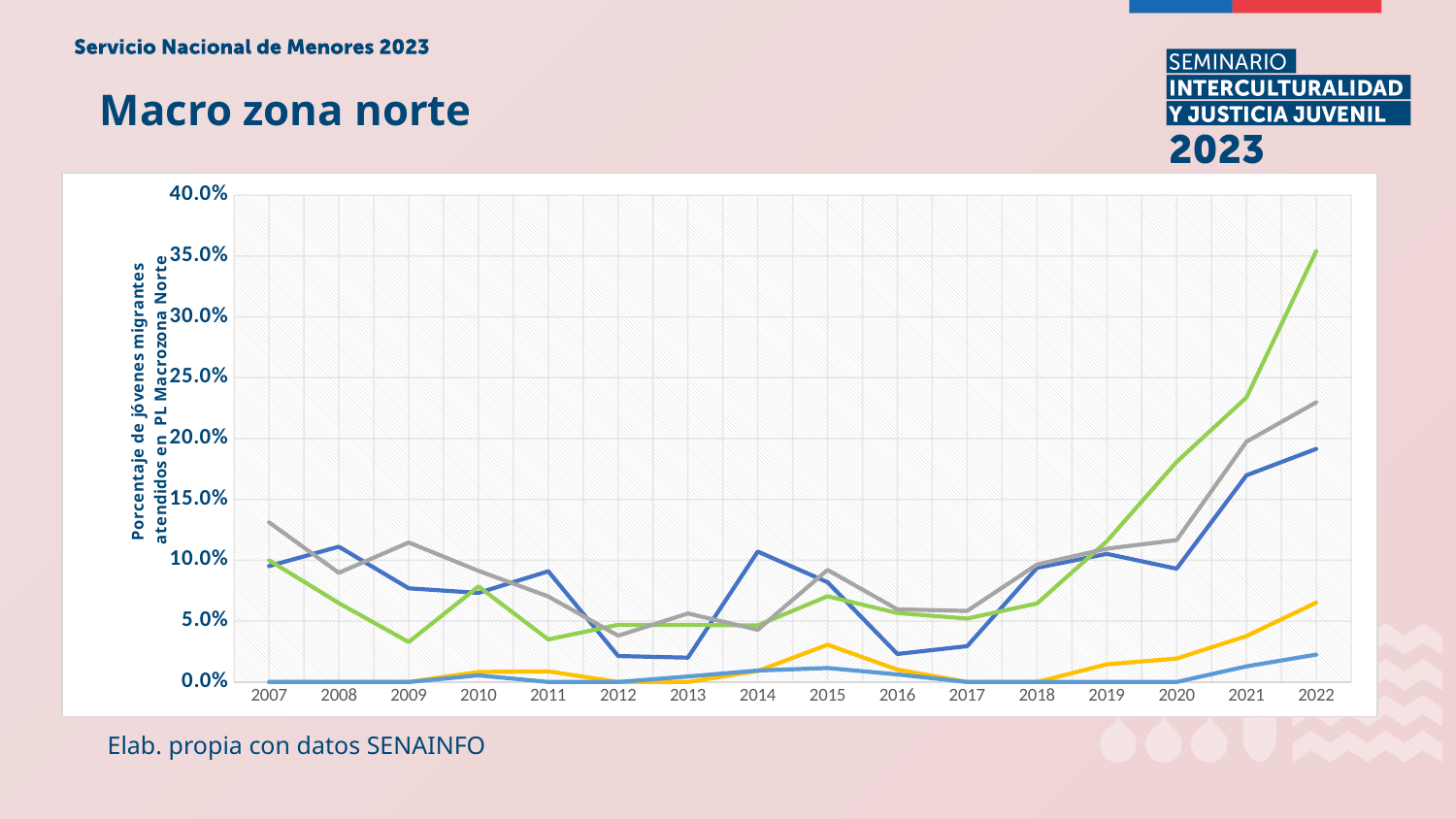
What kind of chart is shown on the slide? line chart In which year does the green line reach its highest value? 2022 How many lines are plotted on the chart? 5 How many years are shown along the x axis of the chart? 16 What is the title of the y axis of the chart? Porcentaje de jóvenes migrantes atendidos en PL Macrozona Norte Does the green line rise or fall between 2018 and 2022? rise Is the value of the green line in 2022 greater or less than 30.0%? greater Is the value of the dark blue line in 2016 greater or less than 5.0%? less What is the highest value shown on the y axis of the chart? 40.0% Is the value of the yellow line in 2022 greater or less than 10.0%? less In 2022, which line has the larger value, the green line or the gray line? green line